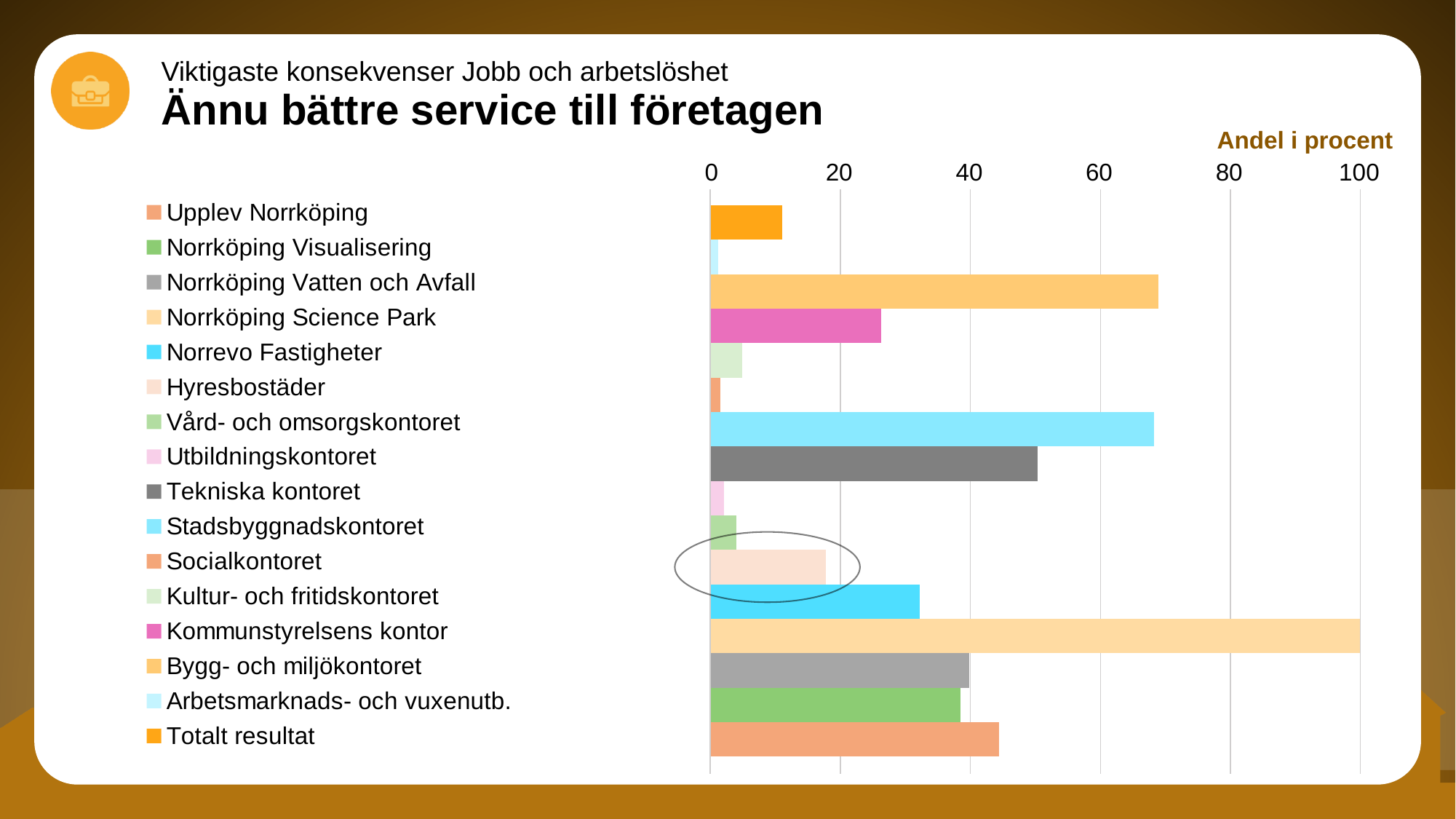
Is the value for Hyresbostäder greater or less than 20? less Is the value for Stadsbyggnadskontoret greater or less than 60? greater Is the value for Bygg- och miljökontoret greater or less than 60? greater Which is larger, the value for Tekniska kontoret or the value for Kommunstyrelsens kontor? Tekniska kontoret What kind of chart is shown on the slide? Bar chart Which category has the highest value in the chart? Norrköping Science Park What label is shown above the horizontal axis of the chart? Andel i procent Which is larger, the value for Upplev Norrköping or the value for Norrevo Fastigheter? Upplev Norrköping How many categories does the legend of the chart list? 16 Which category's bar is circled in the chart? Hyresbostäder